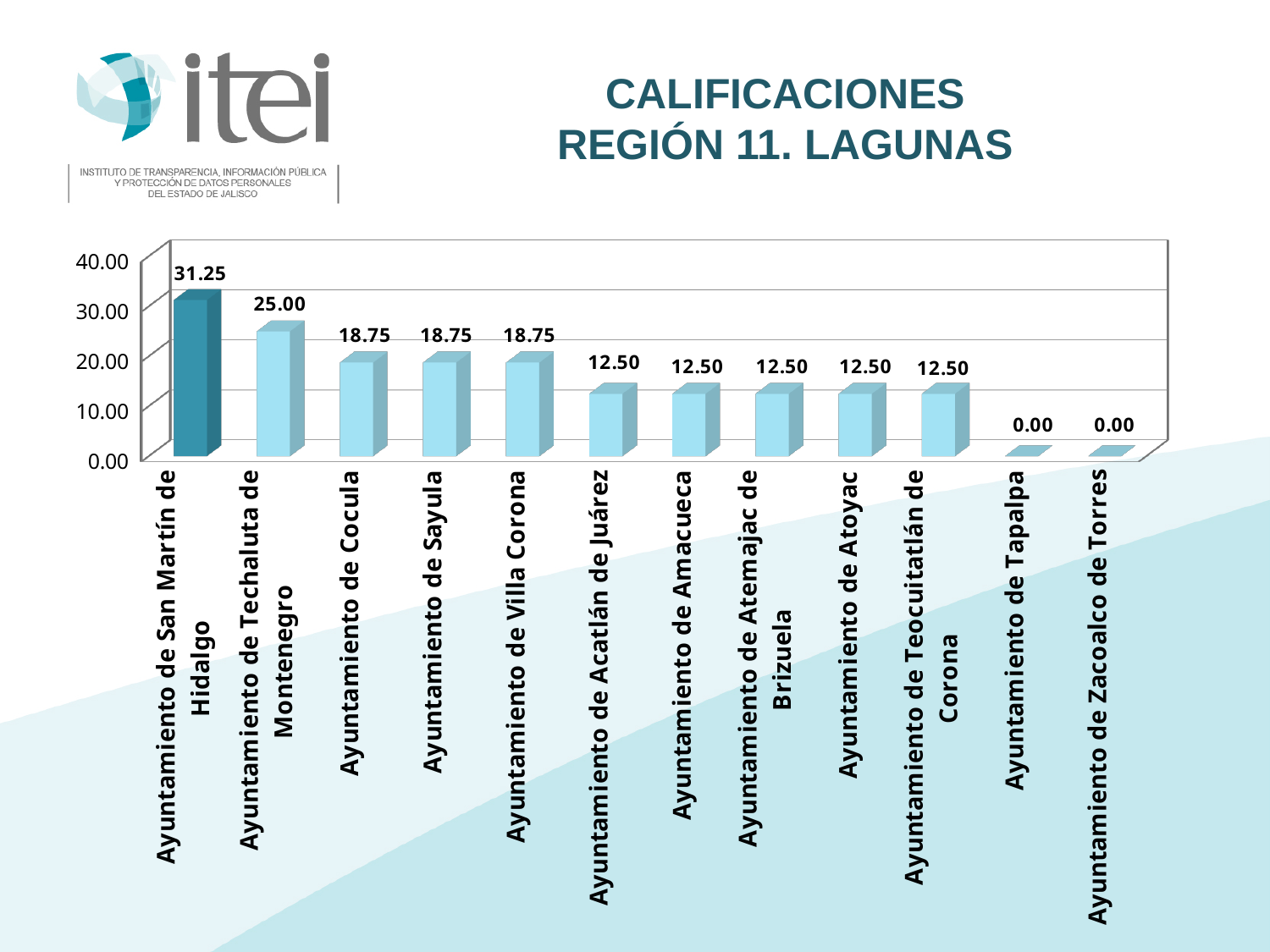
What kind of chart is shown on the slide? bar chart What is the difference between the values for Ayuntamiento de San Martín de Hidalgo and Ayuntamiento de Techaluta de Montenegro? 6.25 How many categories are shown on the x axis? 12 Which is larger, the value for Ayuntamiento de Sayula or the value for Ayuntamiento de Amacueca? Ayuntamiento de Sayula What is the value for Ayuntamiento de Techaluta de Montenegro? 25.00 What is the value for Ayuntamiento de Acatlán de Juárez? 12.50 What is the value for Ayuntamiento de Tapalpa? 0.00 Do the values rise or fall from left to right along the x axis? fall What is the difference between the values for Ayuntamiento de Cocula and Ayuntamiento de Atoyac? 6.25 Is the value for Ayuntamiento de Techaluta de Montenegro greater or less than 20.00? greater Which category has the highest value? Ayuntamiento de San Martín de Hidalgo What is the value for Ayuntamiento de San Martín de Hidalgo? 31.25